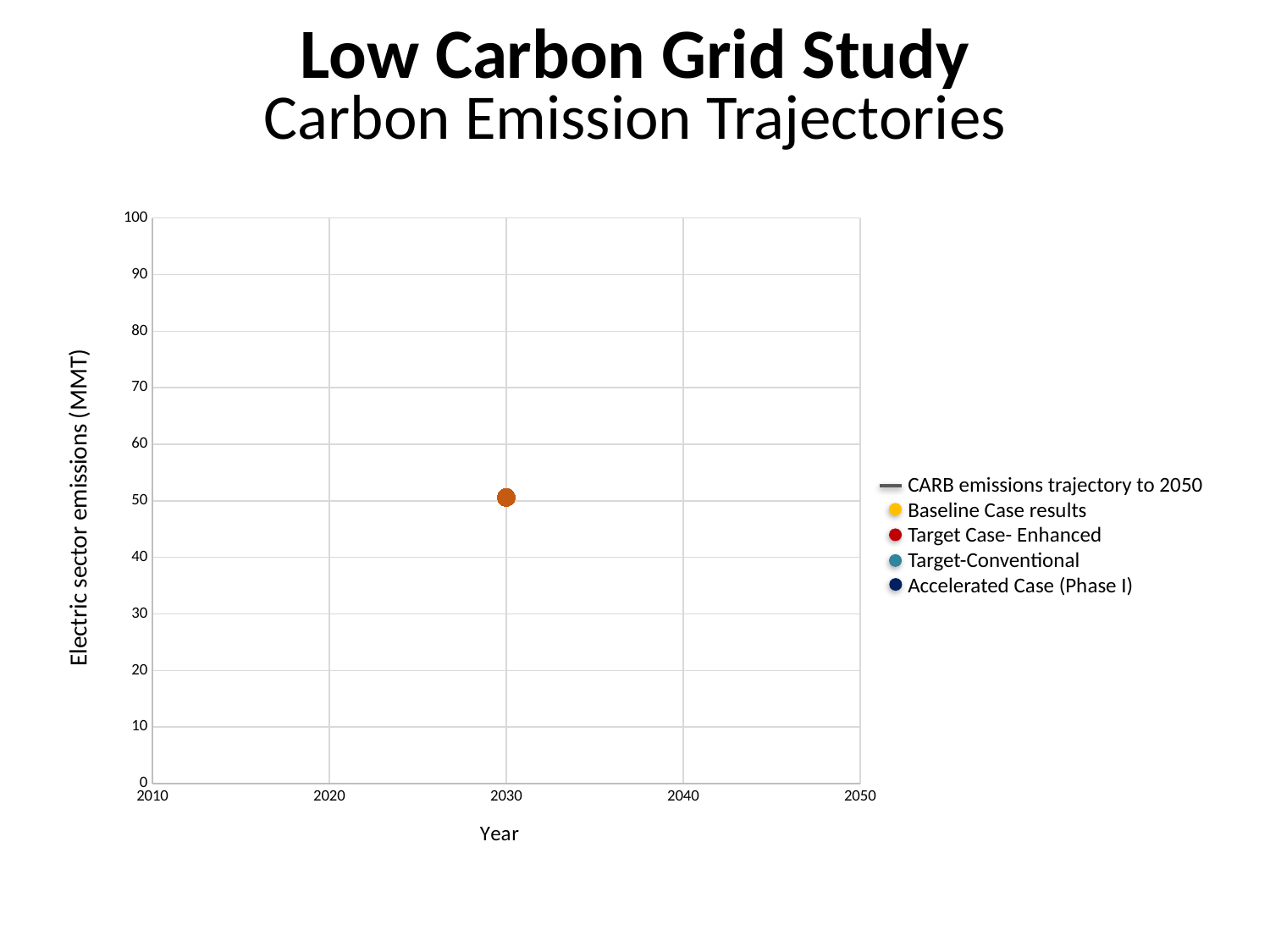
What is the label of the y axis? Electric sector emissions (MMT) In which year is the plotted data point located? 2030 Is the value of the plotted point at 2030 greater or less than 40? greater What is the maximum value shown on the y axis? 100 Is the value of the plotted point at 2030 greater or less than 60? less How many series does the legend list? 5 How many data points are plotted on the chart? 1 What is the last year shown on the x axis? 2050 What is the label of the x axis? Year What kind of chart is shown on the slide? scatter chart